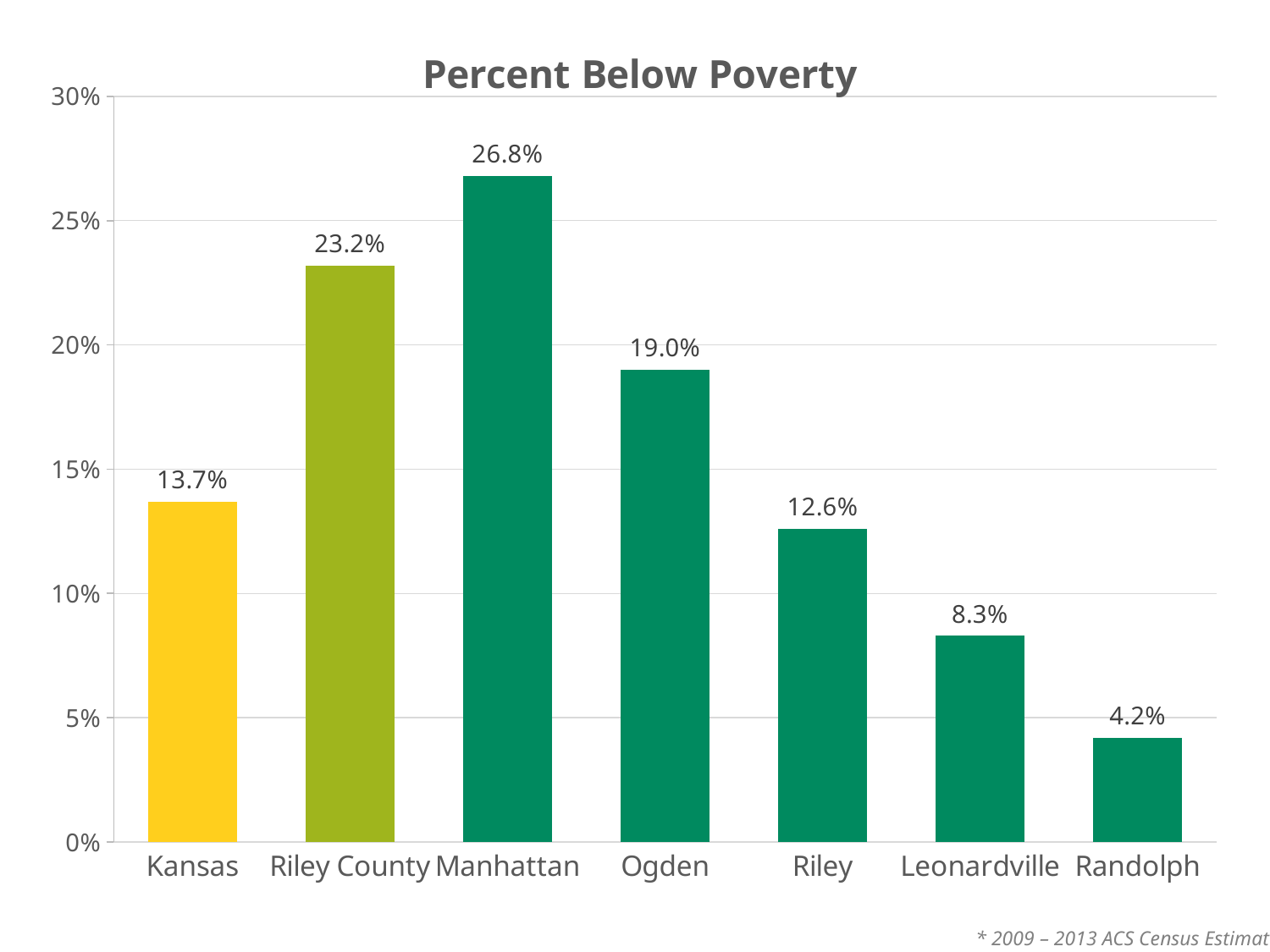
How many categories are shown on the chart? 7 What is the percent below poverty for Manhattan? 26.8% Is the value for Riley County greater or less than 20%? greater What is the percent below poverty for Kansas? 13.7% What is the difference between the percent below poverty for Ogden and Riley? 6.4% What is the title of the chart? Percent Below Poverty Which category has the highest percent below poverty? Manhattan Which category has the lowest percent below poverty? Randolph What kind of chart is shown on the slide? Bar chart Which has a higher percent below poverty, Ogden or Riley? Ogden What is the percent below poverty for Leonardville? 8.3% What is the difference between the percent below poverty for Riley County and Kansas? 9.5%